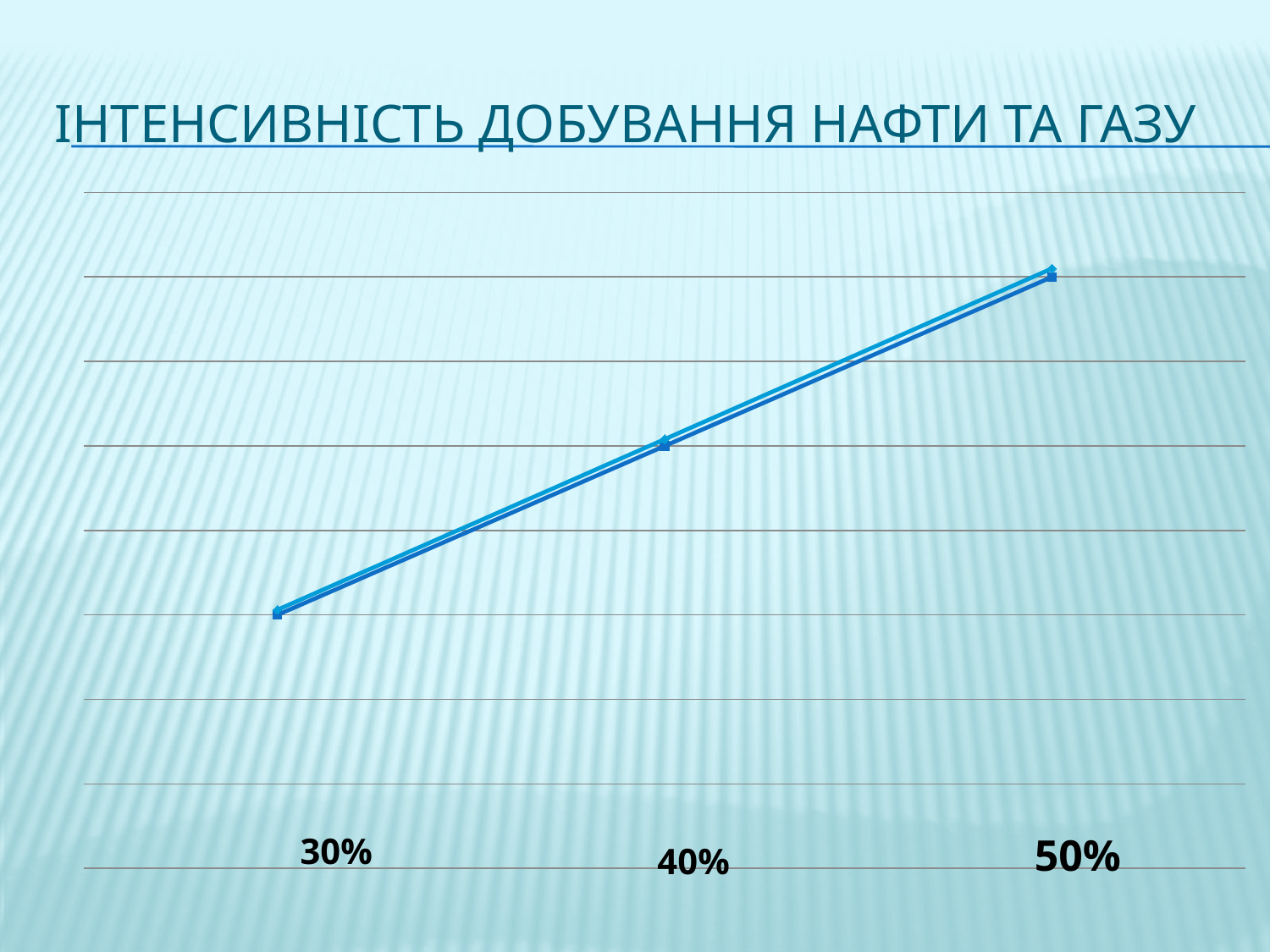
What is the title of the chart on the slide? ІНТЕНСИВНІСТЬ ДОБУВАННЯ НАФТИ ТА ГАЗУ Do the plotted values rise or fall as you move from 30% to 50% along the x axis? rise What kind of chart is shown on the slide? line chart Which x-axis category has the highest plotted value? 50% Which has the larger plotted value, the 30% category or the 50% category? 50% Which x-axis category has the lowest plotted value? 30% What are the categories listed along the x axis of the chart? 30%, 40%, 50% How many categories are shown on the x axis of the chart? 3 Which has the larger plotted value, the 40% category or the 30% category? 40%